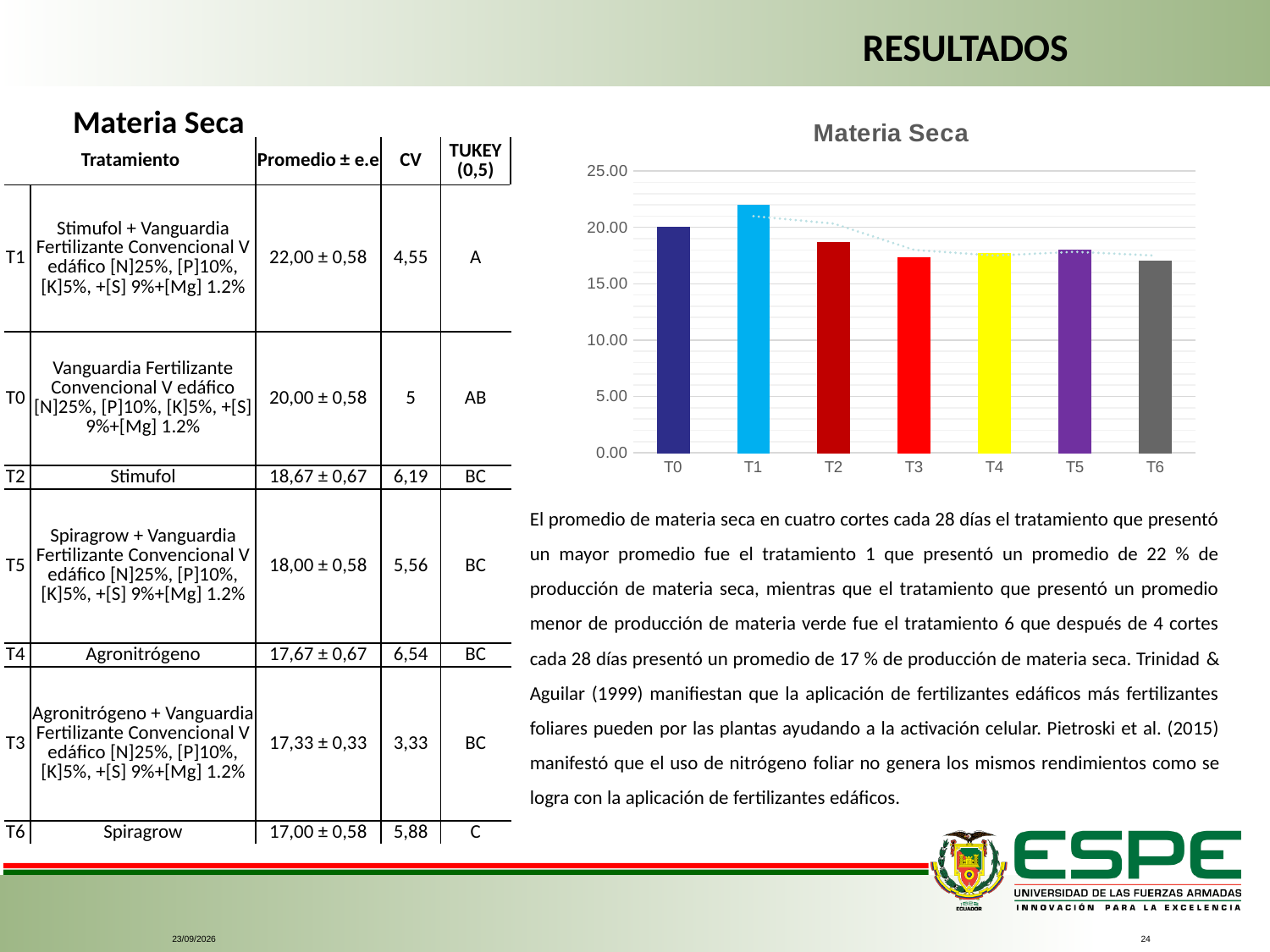
What is the value for T0 in the chart? 20.00 What colour is the bar for T4? yellow What is the title of the chart? Materia Seca From T1 to T6, do the bar values generally rise or fall? fall Is the value for T6 greater or less than 20.00? less Is the value for T5 greater or less than 15.00? greater Which is larger, the value for T1 or the value for T2? T1 Is the value for T1 greater or less than 20.00? greater What kind of chart is shown on the slide? bar chart Which treatment has the highest bar in the chart? T1 How many treatments (bars) are plotted in the chart? 7